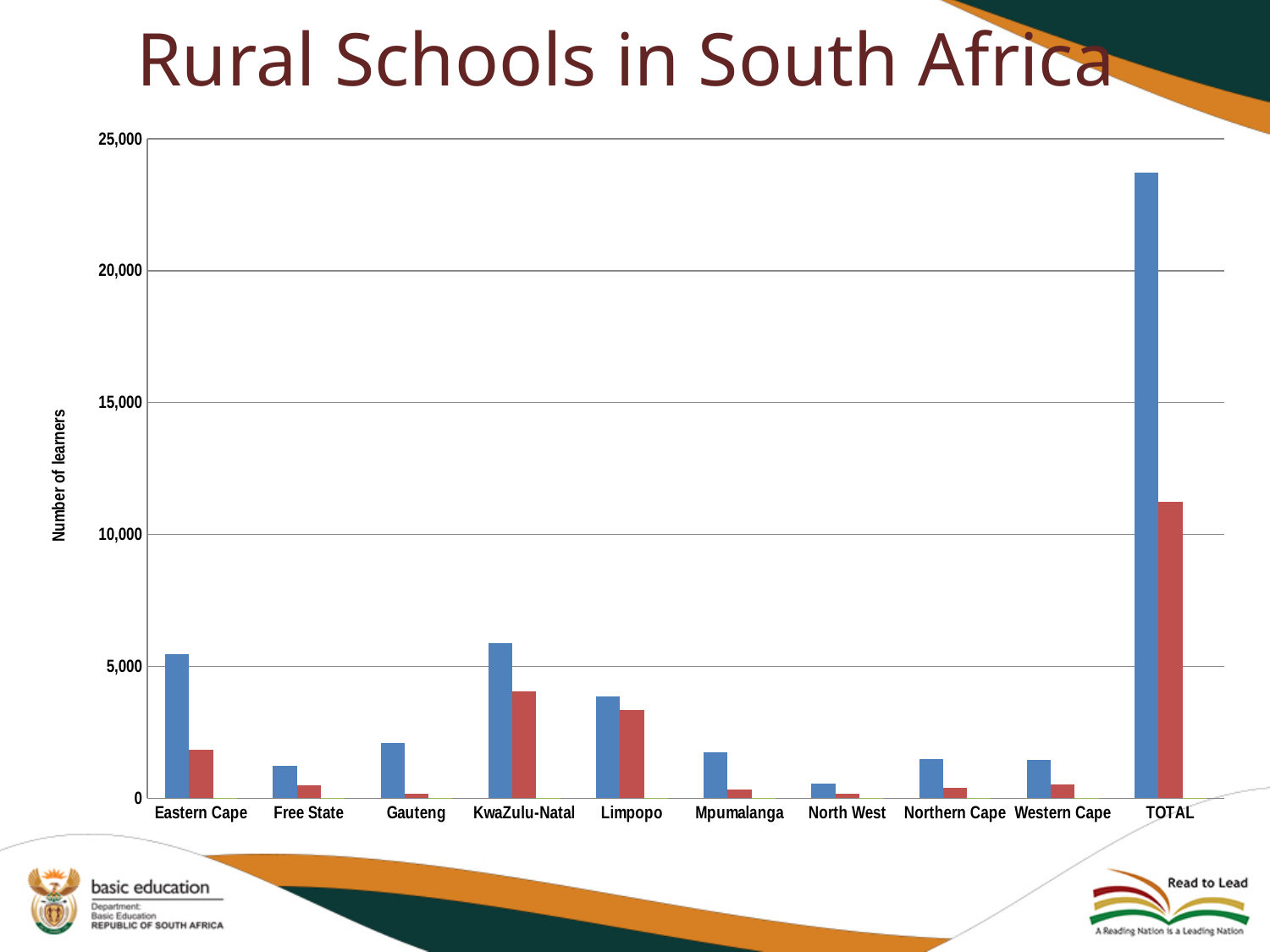
Is the red bar for TOTAL greater or less than 10,000? greater Is the blue bar for Limpopo greater or less than 5,000? less Excluding TOTAL, which province has the highest blue bar? KwaZulu-Natal How many categories are shown along the x axis of the chart? 10 Which province has the lowest blue bar? North West What is the label on the vertical axis of the chart? Number of learners What kind of chart is shown on the slide? bar chart Is the blue bar for TOTAL greater or less than 20,000? greater Which is larger, the blue bar for Eastern Cape or the blue bar for Free State? Eastern Cape What is the title of the slide containing the chart? Rural Schools in South Africa